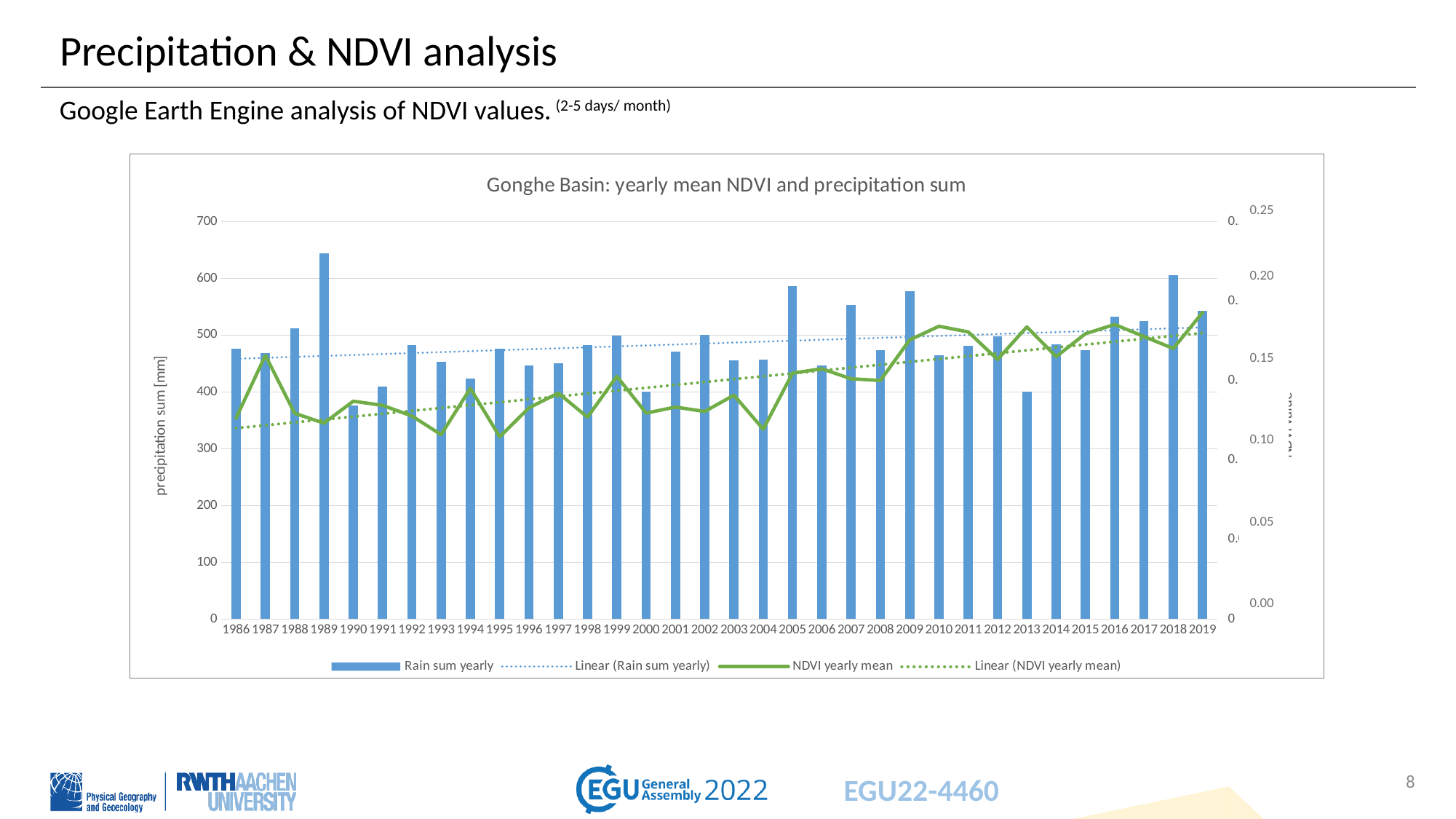
Is the NDVI yearly mean for 2004 greater or less than 0.15? less How many years are shown on the x axis of the chart? 34 Which year has the larger yearly rain sum, 2004 or 2005? 2005 What is the title of the chart? Gonghe Basin: yearly mean NDVI and precipitation sum Is the yearly rain sum for 1989 greater or less than 600? greater What kind of chart is used to show the 'Rain sum yearly' series? bar chart Which year has the highest yearly rain sum? 1989 Is the yearly rain sum for 2013 greater or less than 500? less Which year has the larger yearly rain sum, 1989 or 2018? 1989 Does the linear trend line for the NDVI yearly mean rise or fall from 1986 to 2019? rise How many series does the chart legend list? 4